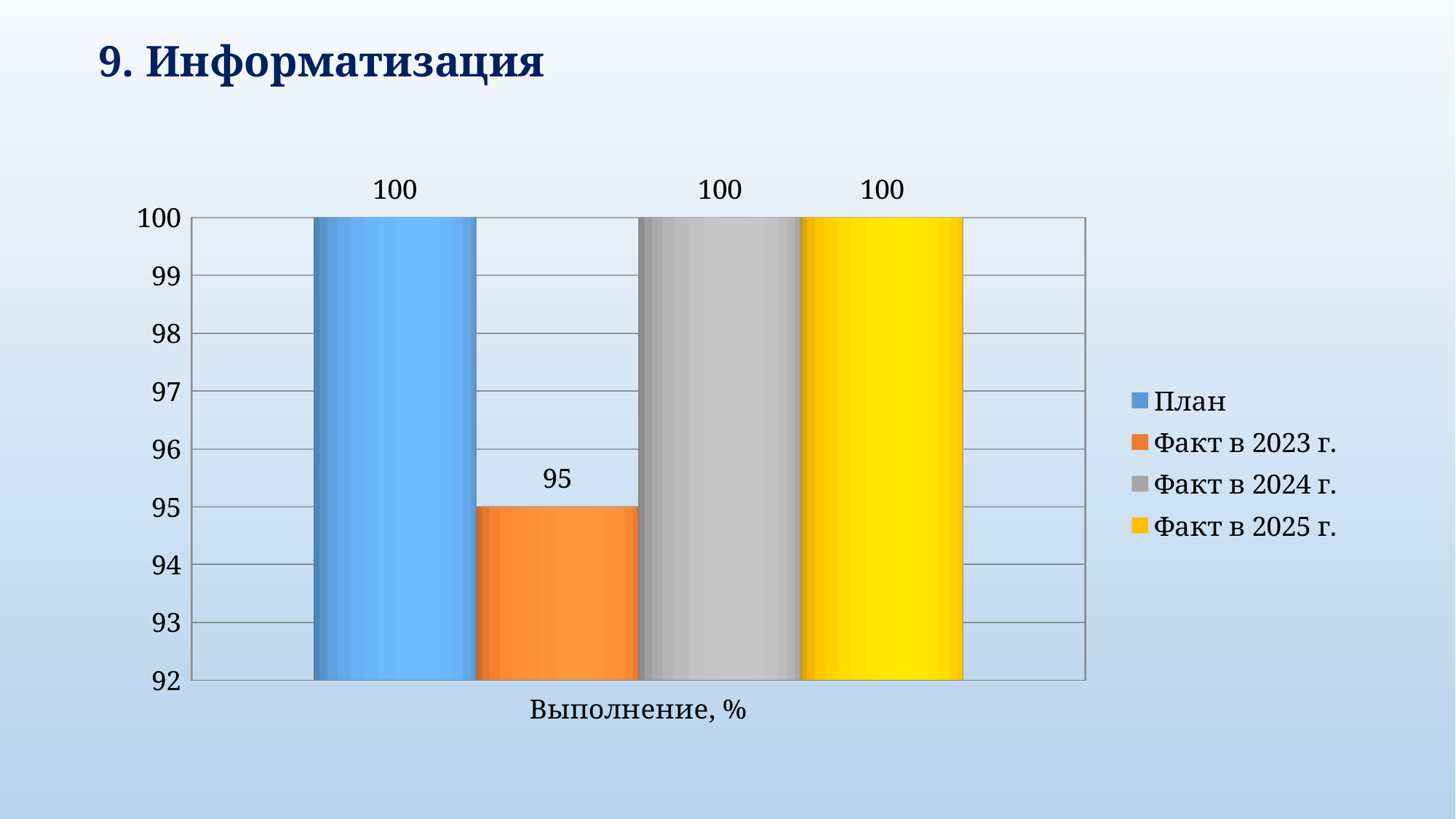
Which is larger, the value for Факт в 2023 г. or the value for Факт в 2024 г.? Факт в 2024 г. What is the value of the Факт в 2025 г. series? 100 What colour is the bar for Факт в 2025 г.? yellow What is the value of the План series? 100 What kind of chart is shown on the slide? bar chart How many series does the legend list? 4 What is the value of the Факт в 2024 г. series? 100 Which series has the lowest value? Факт в 2023 г. What is the label on the x axis of the chart? Выполнение, % Is the value for Факт в 2023 г. greater or less than 97? less What is the difference between the План value and the Факт в 2023 г. value? 5 What is the value of the Факт в 2023 г. series? 95